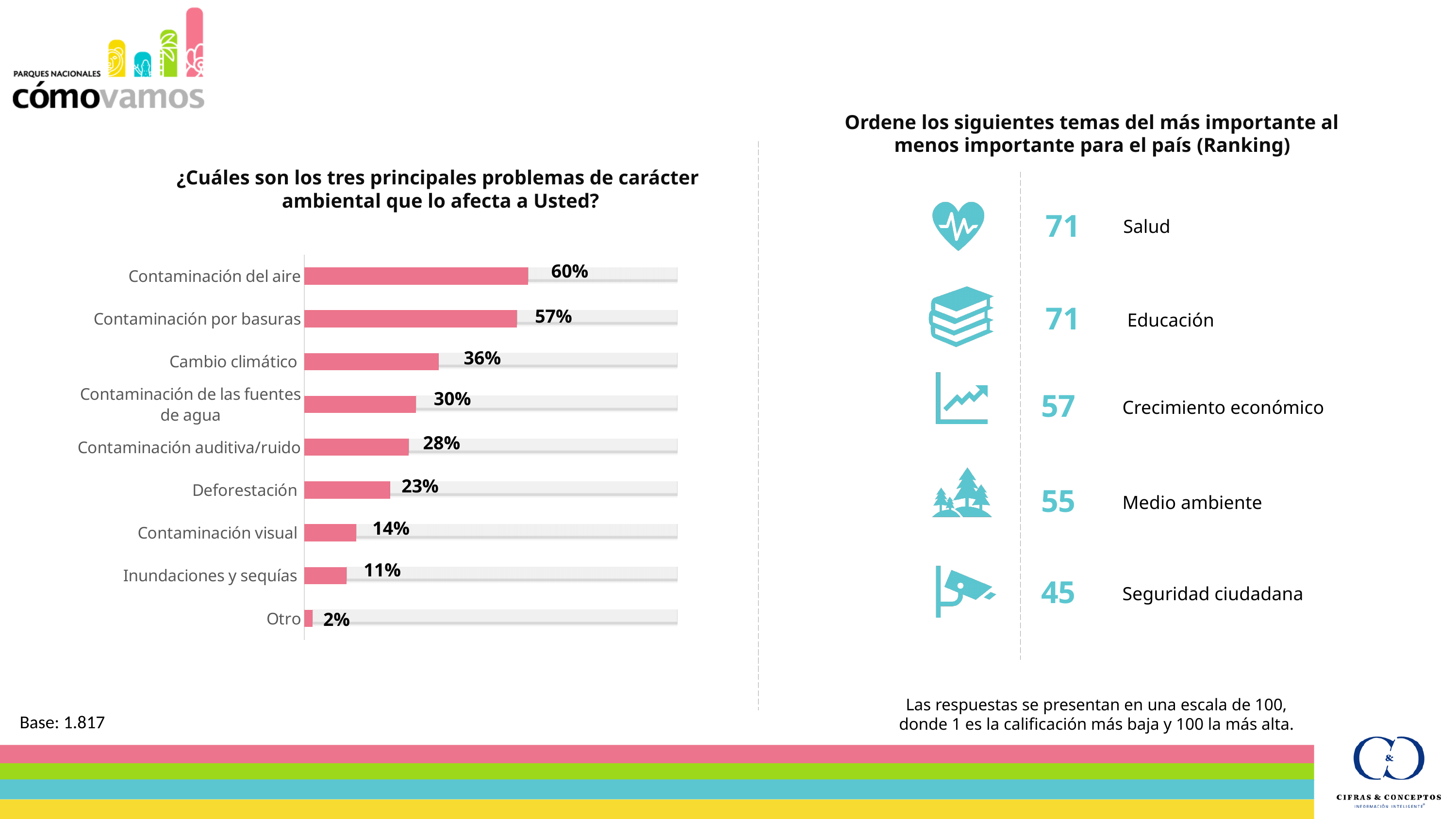
How many categories are shown in the bar chart on the left? 9 In the bar chart on the left, what is the value for Cambio climático? 36% In the ranking on the right, what is the score for Medio ambiente? 55 In the bar chart on the left, which category has the highest value? Contaminación del aire In the bar chart on the left, what is the value for Deforestación? 23% In the bar chart on the left, which is larger: Contaminación auditiva/ruido or Contaminación visual? Contaminación auditiva/ruido What type of chart is shown on the left of the slide? Bar chart In the bar chart on the left, what is the difference between Contaminación del aire and Contaminación por basuras? 3% In the ranking on the right, which topic has the lowest score? Seguridad ciudadana In the bar chart on the left, what is the value for Contaminación del aire? 60% In the bar chart on the left, which category has the lowest value? Otro In the bar chart on the left, what is the difference between Contaminación de las fuentes de agua and Inundaciones y sequías? 19%